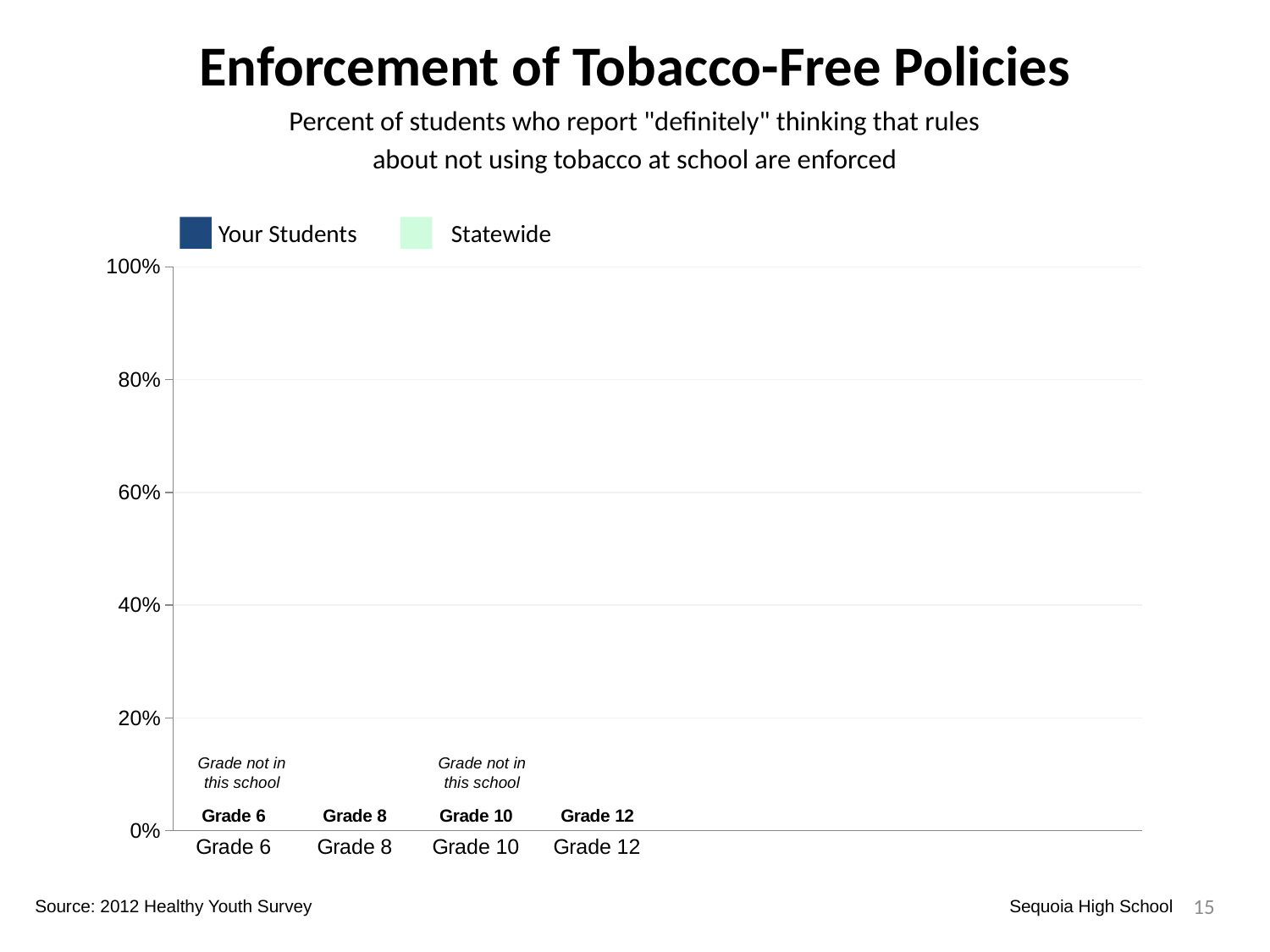
What is the first grade category listed on the x axis? Grade 6 What is the lowest value shown on the chart's y axis? 0% How many series does the chart's legend list? 2 What is the last grade category listed on the x axis? Grade 12 Which grade categories are marked "Grade not in this school" on the chart? Grade 6 and Grade 10 What are the two series named in the chart's legend? Your Students and Statewide What is the title of the chart? Enforcement of Tobacco-Free Policies What is the highest value shown on the chart's y axis? 100% How many grade categories are shown on the x axis of the chart? 4